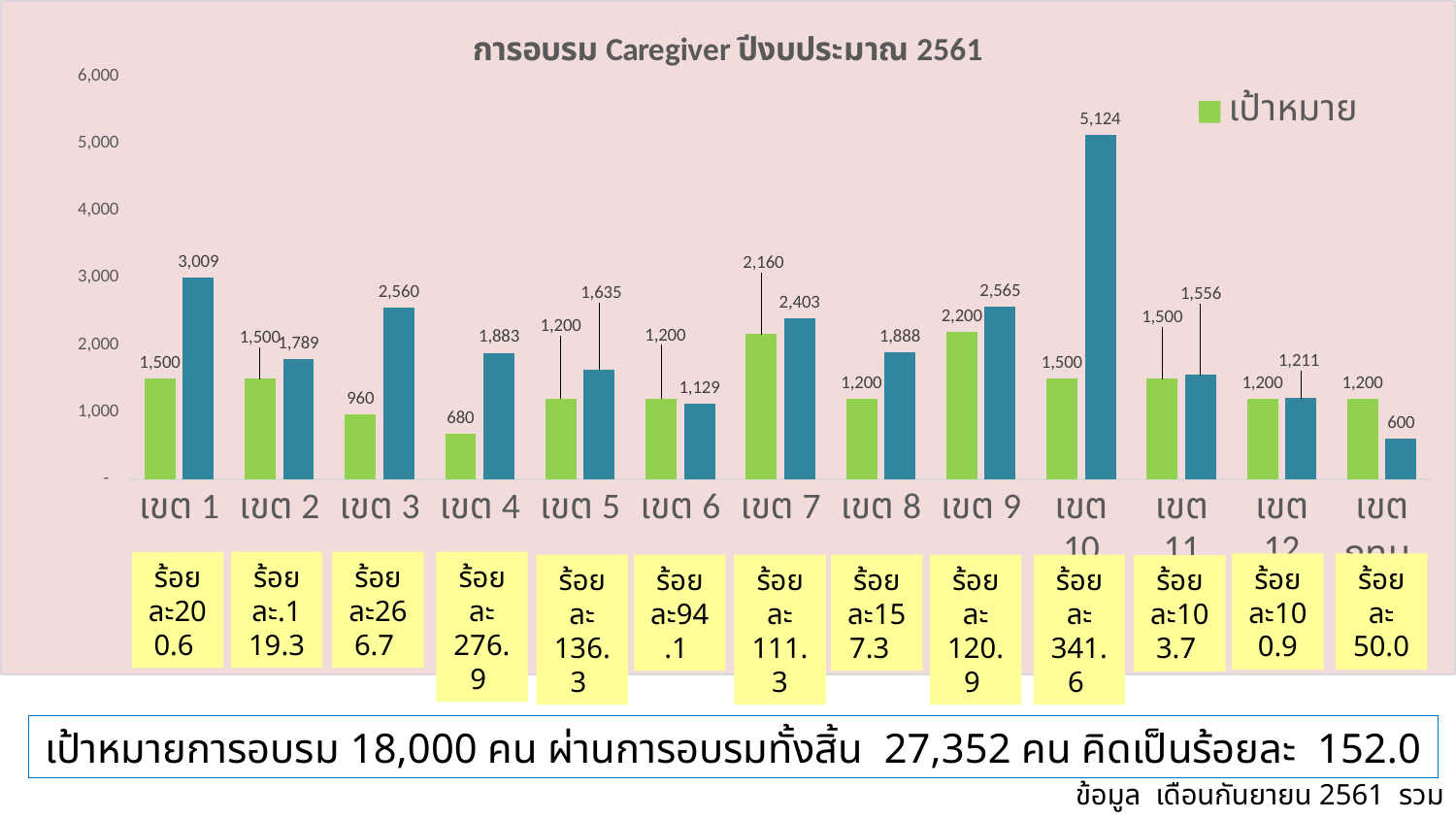
What is the เป้าหมาย (green bar) value for เขต 7? 2,160 Which category has the lowest เป้าหมาย (green bar) value? เขต 4 What is the title of the chart? การอบรม Caregiver ปีงบประมาณ 2561 For เขต 6, which is larger: the green bar or the blue bar? the green bar What is the value of the blue bar for เขต 10? 5,124 How many categories (เขต) are shown on the x axis of the chart? 13 Which category has the highest blue bar? เขต 10 What kind of chart is shown on the slide? bar chart What is the difference between the blue bar and the green bar for เขต 1? 1,509 How many series does the chart legend list? 1 What is the เป้าหมาย (green bar) value for เขต 4? 680 Is the blue bar value for เขต 10 greater or less than 5,000? greater